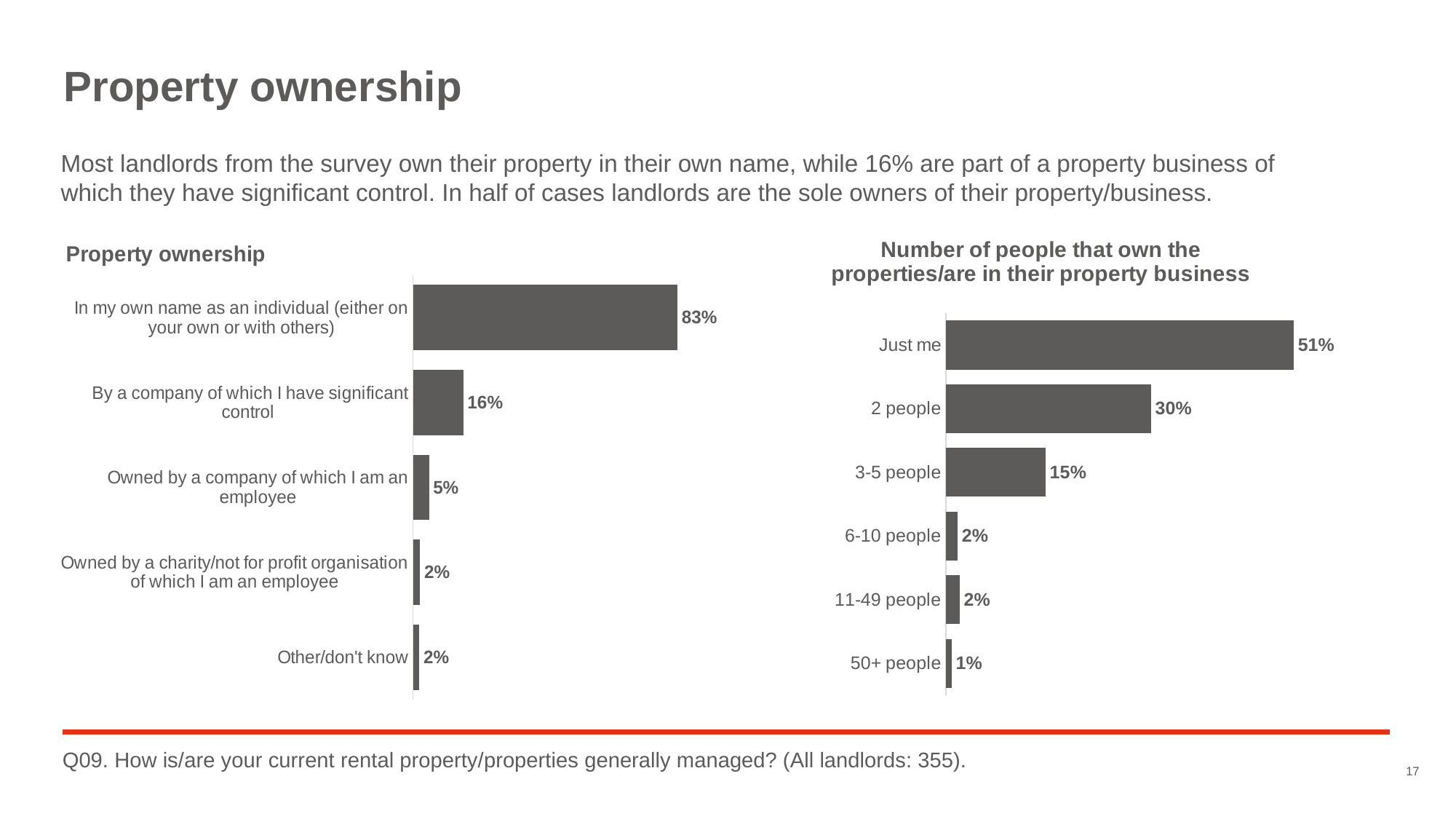
In the 'Property ownership' chart, which category has the highest value? In my own name as an individual (either on your own or with others) In the 'Number of people that own the properties/are in their property business' chart, what is the value for '3-5 people'? 15% In the 'Property ownership' chart, what is the value for 'In my own name as an individual (either on your own or with others)'? 83% In the 'Property ownership' chart, how many categories are shown? 5 In the 'Number of people that own the properties/are in their property business' chart, what is the difference between 'Just me' and '3-5 people'? 36% In the 'Number of people that own the properties/are in their property business' chart, which is larger: 'Just me' or '2 people'? Just me In the 'Property ownership' chart, what is the value for 'By a company of which I have significant control'? 16% In the 'Number of people that own the properties/are in their property business' chart, which category has the lowest value? 50+ people In the 'Number of people that own the properties/are in their property business' chart, what is the value for '2 people'? 30% What type of chart is the 'Property ownership' chart? Bar chart In the 'Number of people that own the properties/are in their property business' chart, how many categories are shown? 6 In the 'Property ownership' chart, what is the difference between 'In my own name as an individual' and 'By a company of which I have significant control'? 67%